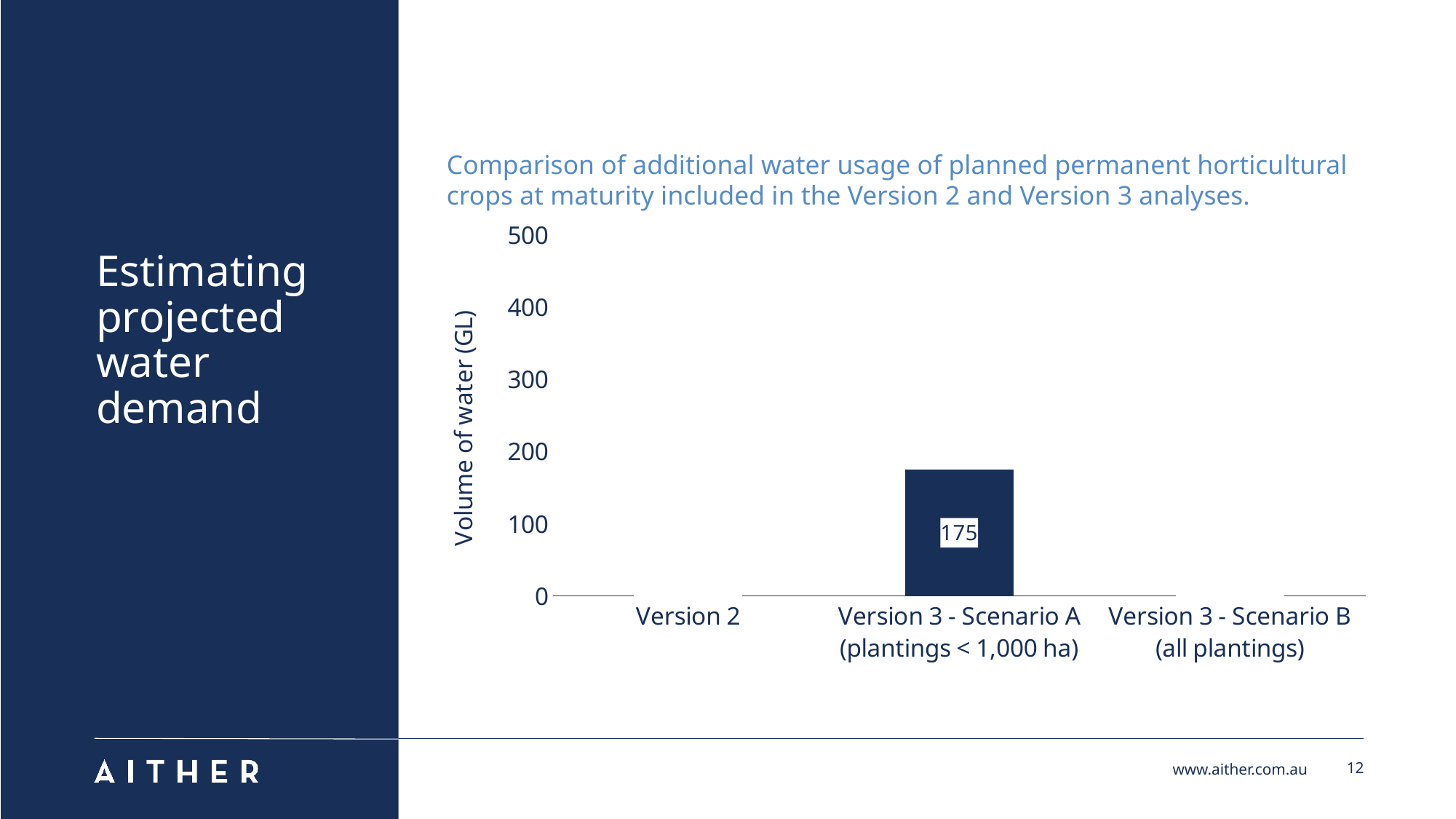
What is the label of the third category on the x axis? Version 3 - Scenario B (all plantings) What is the highest value shown on the y axis? 500 What is the label of the first category on the x axis? Version 2 Is the value for Version 3 - Scenario A (plantings < 1,000 ha) greater or less than 200? less What kind of chart is shown on the slide? bar chart Which category has the highest value shown in the chart? Version 3 - Scenario A (plantings < 1,000 ha) What is the label of the y axis? Volume of water (GL) What is the value for Version 3 - Scenario A (plantings < 1,000 ha)? 175 Is the value for Version 3 - Scenario A (plantings < 1,000 ha) greater or less than 100? greater How many categories are shown on the x axis? 3